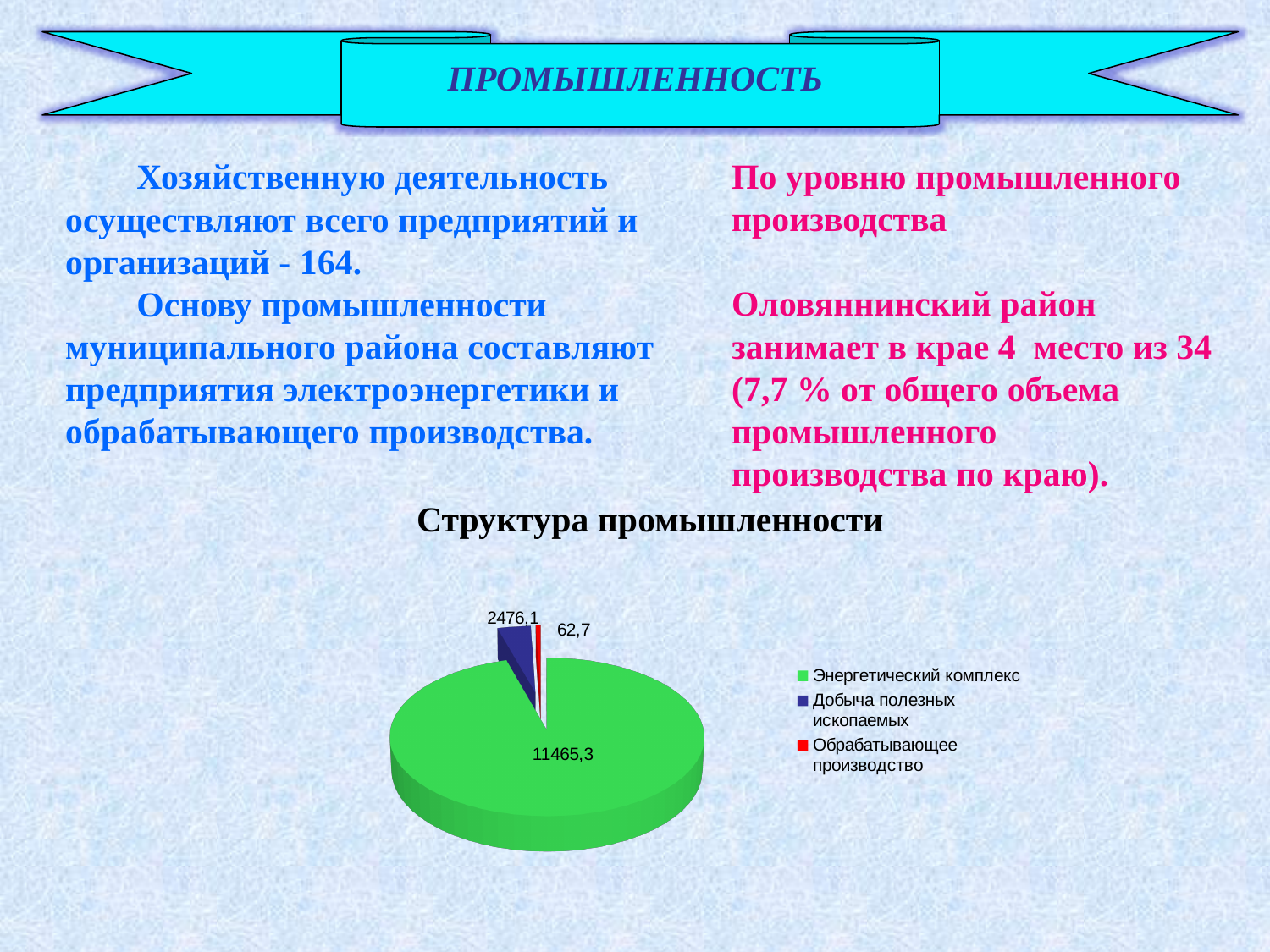
What is the total of all three values in the pie chart? 14004,1 What is the value for «Энергетический комплекс» in the pie chart? 11465,3 What is the value for «Обрабатывающее производство» in the pie chart? 62,7 Which is larger: the value for «Добыча полезных ископаемых» or for «Обрабатывающее производство»? Добыча полезных ископаемых What kind of chart is shown under the heading «Структура промышленности»? pie chart Which category has the largest slice in the pie chart? Энергетический комплекс What is the difference between the values for «Энергетический комплекс» and «Добыча полезных ископаемых»? 8989,2 How many categories does the pie chart show? 3 What is the difference between the values for «Добыча полезных ископаемых» and «Обрабатывающее производство»? 2413,4 Which category has the smallest slice in the pie chart? Обрабатывающее производство What is the value for «Добыча полезных ископаемых» in the pie chart? 2476,1 What colour is the slice for «Энергетический комплекс» in the pie chart? green